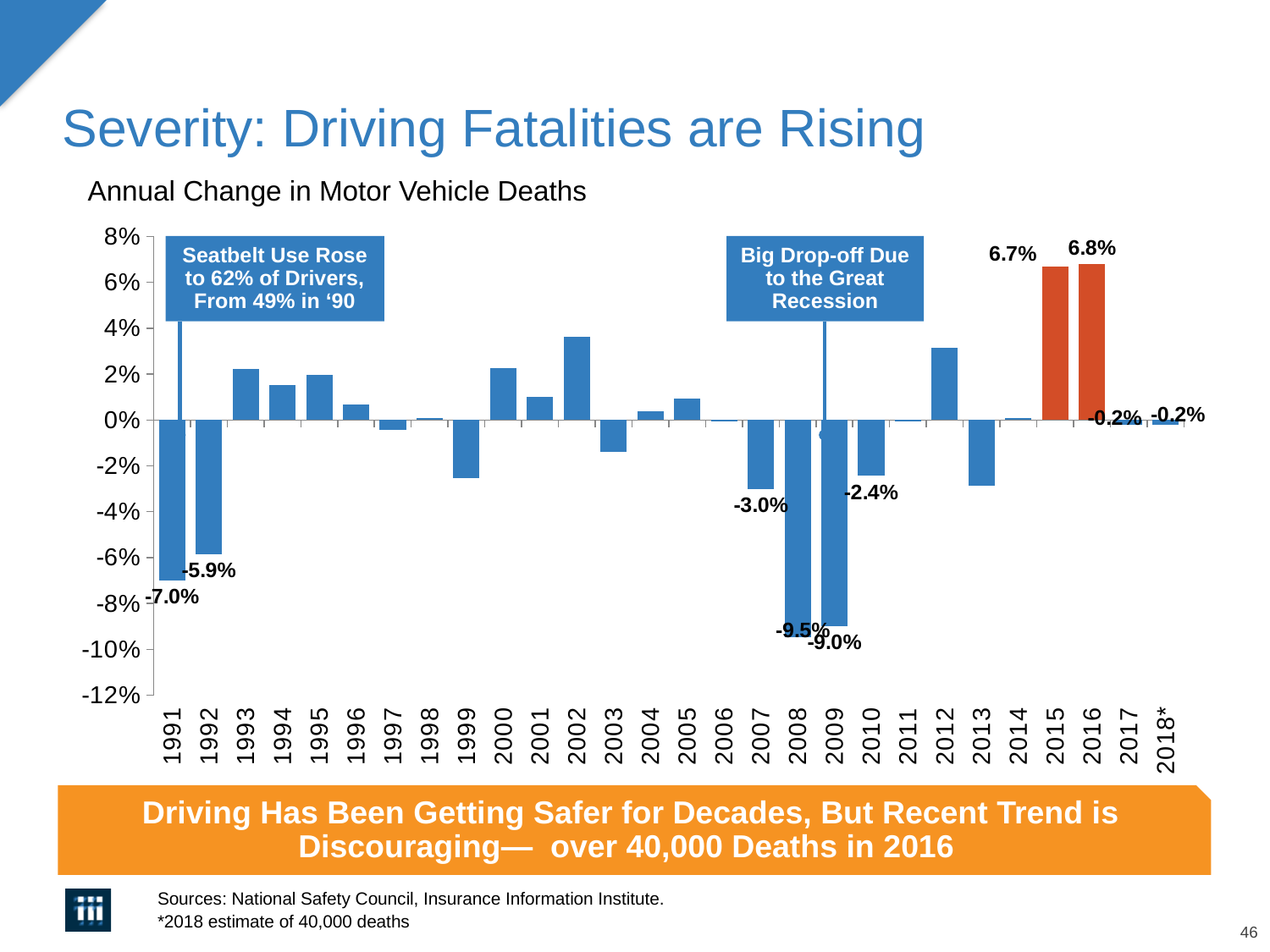
What value is labeled for 2008? -9.5% Is the value for 2002 greater or less than 2%? greater What is the annual change in motor vehicle deaths shown for 1991? -7.0% How many years are shown on the x axis? 28 What value is labeled for 2018*? -0.2% What is the value shown for 2016? 6.8% Is the value for 1999 greater or less than -2%? less What type of chart is shown on the slide? Bar chart Which year has a larger annual change, 2007 or 2010? 2010 Which year has the highest annual change in motor vehicle deaths? 2016 What is the difference between the values for 1991 and 1992? 1.1 percentage points Which year has the lowest annual change in motor vehicle deaths? 2008